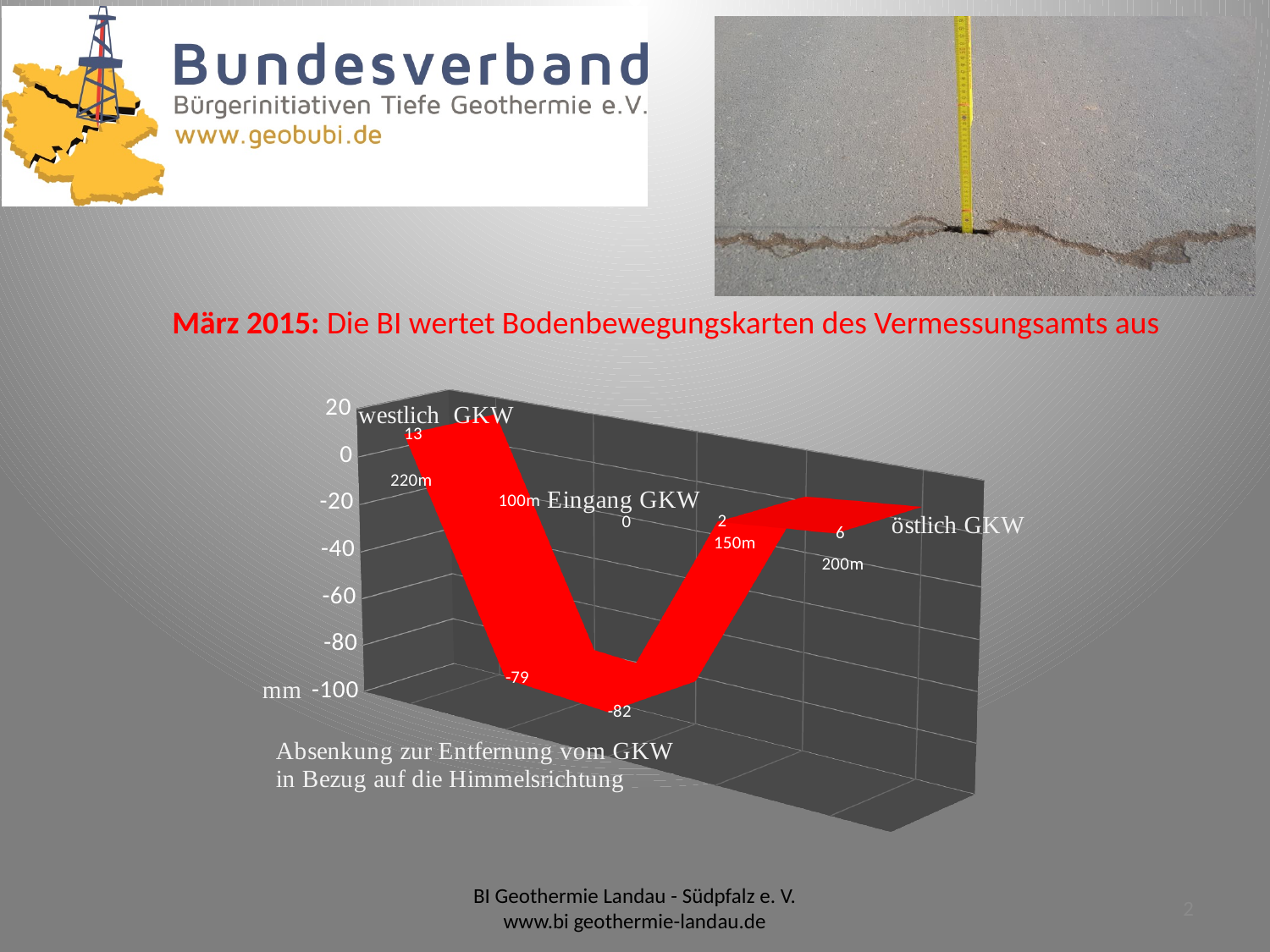
What is the difference between the value at 220m westlich (13) and at 200m östlich (6)? 7 What is the value at the Eingang GKW (0)? -82 What is the value at 150m östlich of the GKW? 2 How many data points are labelled on the chart? 5 What is the value at 100m from the GKW? -79 At which point is the value lowest? Eingang GKW (0) What unit is shown on the vertical axis of the chart? mm What is the difference between the values at 100m (-79) and at the Eingang GKW (-82)? 3 What is the value at 200m östlich GKW? 6 What is the value at 220m westlich GKW? 13 Which is larger, the value at 150m or the value at 200m? 200m At which point is the value highest? 220m westlich GKW